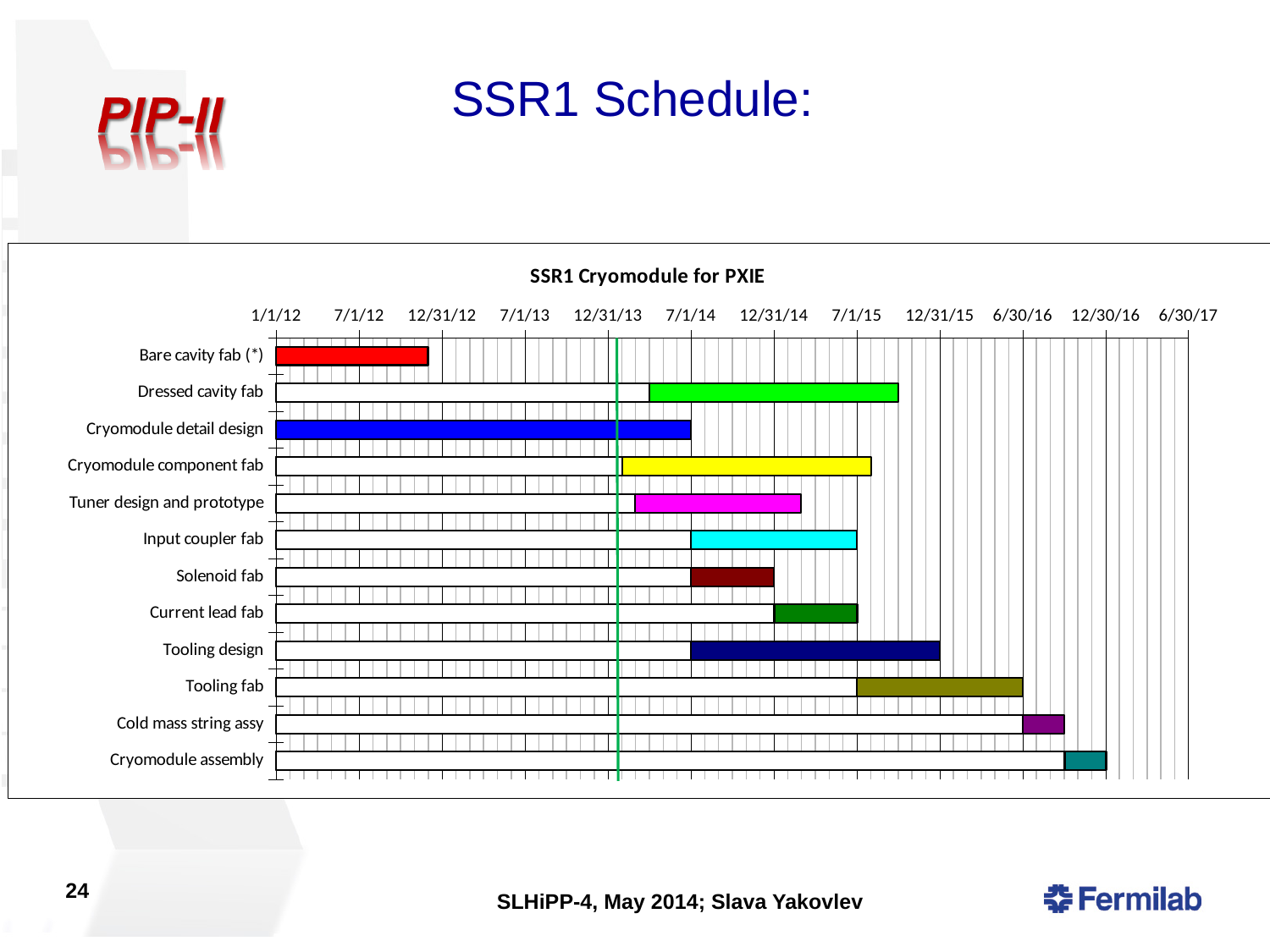
What colour is the bar for Bare cavity fab (*)? Red What kind of chart is shown on the slide? Bar chart (Gantt chart) Which task's bar ends latest on the timeline? Cryomodule assembly Which task's bar ends later, Tooling design or Solenoid fab? Tooling design At which date on the axis does the Bare cavity fab (*) bar start? 1/1/12 At which date on the axis does the Cryomodule detail design bar start? 1/1/12 Does the Dressed cavity fab bar end before or after 7/1/15? after Does the Cryomodule assembly bar start before or after 6/30/16? after Which task has the longest bar in the chart? Cryomodule detail design Which task's bar starts earlier, Tuner design and prototype or Input coupler fab? Tuner design and prototype What is the title of the chart on the slide? SSR1 Cryomodule for PXIE How many tasks are listed on the vertical axis of the chart? 12